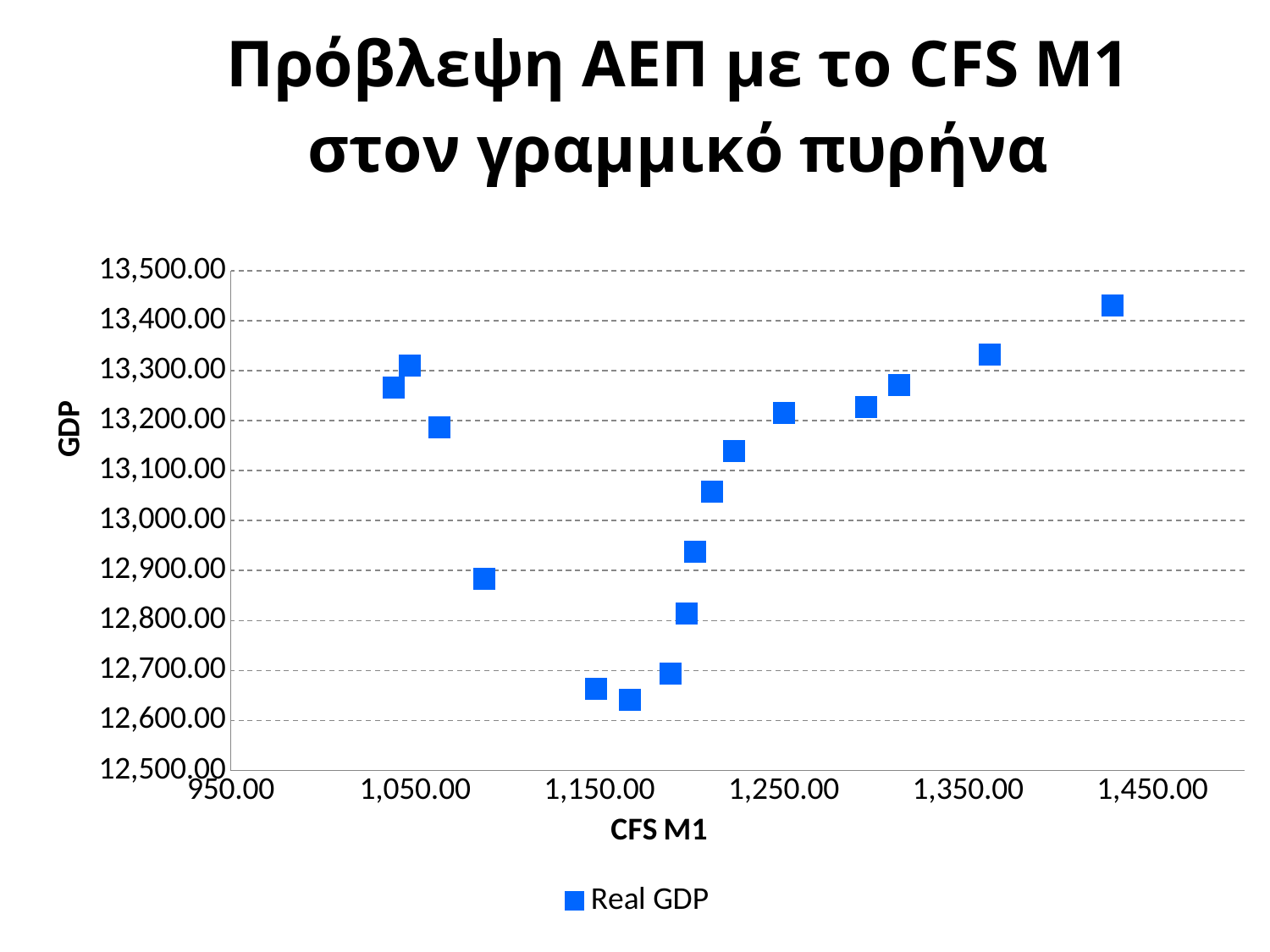
Is the GDP value of the lowest point on the chart greater or less than 12,700? less Is the highest GDP value on the chart found at the left end or the right end of the CFS M1 axis? Right end Is the GDP value of the point near CFS M1 of 1,350 greater or less than 13,300? greater Is the GDP value of the point near CFS M1 of 1,100 greater or less than 13,000? less Which has the higher GDP value: the point near CFS M1 of 1,050 or the point near CFS M1 of 1,150? The point near 1,050 What is the title of the x axis? CFS M1 Do the GDP values rise or fall as CFS M1 increases from about 1,250 to 1,450? rise What is the name of the series shown in the legend? Real GDP How many series does the legend list? 1 What kind of chart is shown on the slide? Scatter chart How many data points are plotted on the chart? 16